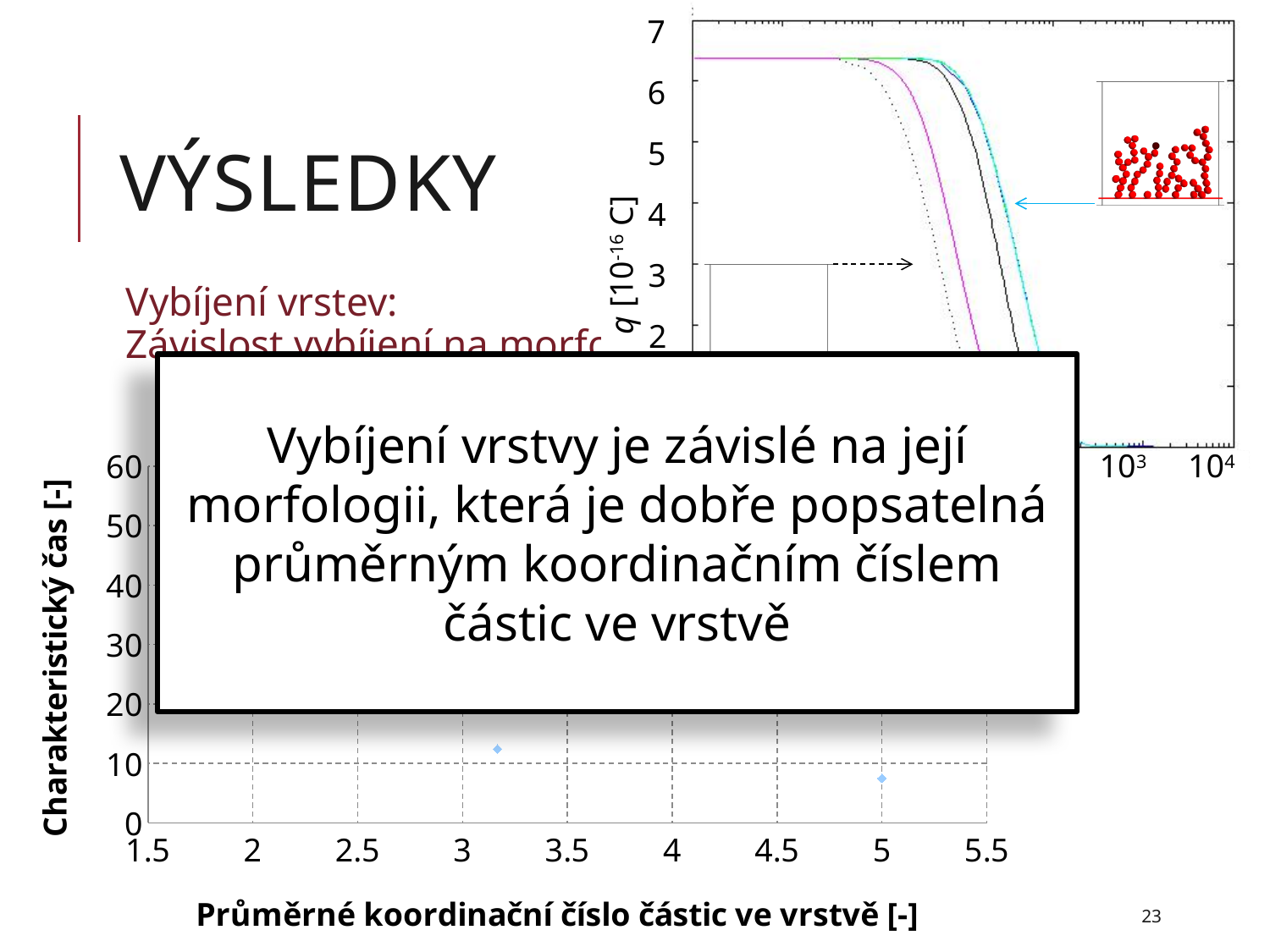
In the bottom chart, is the value of the point near coordination number 3.2 greater or less than 20? less What is the lowest tick value shown on the x axis of the bottom chart? 1.5 In the bottom chart, is the value of the point at coordination number 5 greater or less than 20? less In the bottom chart, is the value of the point at coordination number 5 greater or less than 10? less What is the y-axis title of the bottom chart? Charakteristický čas [-] What kind of chart is the top-right chart with the y axis 'q [10^-16 C]'? line chart What is the highest tick value shown on the y axis of the top-right chart? 7 In the bottom chart, which visible point has the larger characteristic time: the one at coordination number 5 or the one near coordination number 3.2? the one near 3.2 What is the highest tick value shown on the y axis of the bottom chart? 60 What kind of chart is the bottom chart with the x axis 'Průměrné koordinační číslo částic ve vrstvě [-]'? scatter chart What is the x-axis title of the bottom chart? Průměrné koordinační číslo částic ve vrstvě [-] In the top-right chart, do the curves rise or fall as the x value increases past 10^3? fall